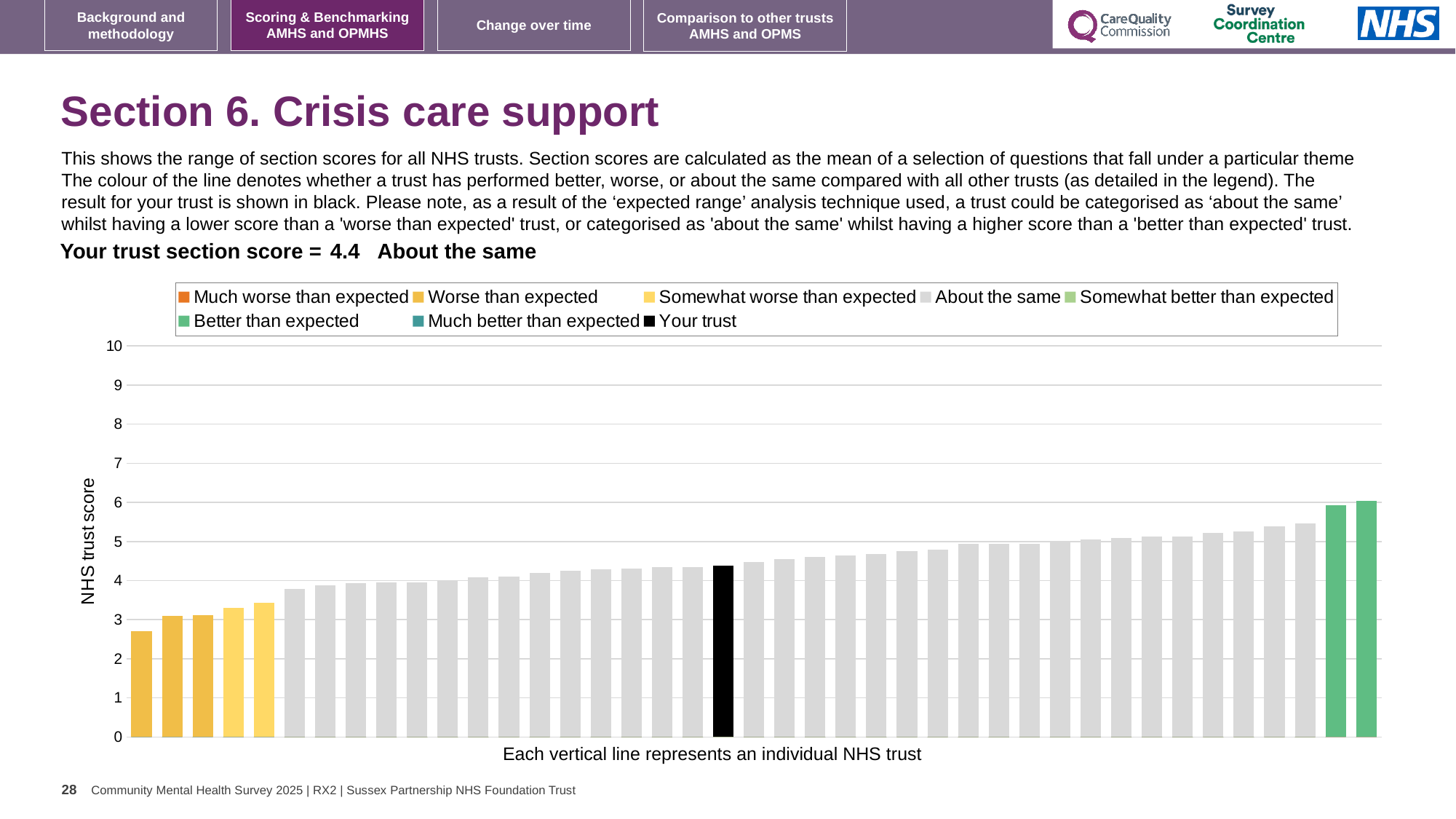
What kind of chart is shown on the slide? bar chart Is the leftmost bar higher or lower than the black bar for your trust? lower What is the section score for your trust shown on the slide? 4.4 Is the value for your trust (the black bar) greater or less than 4? greater How many entries does the chart legend list? 8 How many bars are coloured as 'Better than expected'? 2 Is the value of the rightmost (highest) bar greater or less than 7? less What is the label on the y axis of the chart? NHS trust score Which category is your trust placed in for this section? About the same Is the value of the rightmost (highest) bar greater or less than 5? greater Do the bar values rise or fall from left to right along the x axis? rise